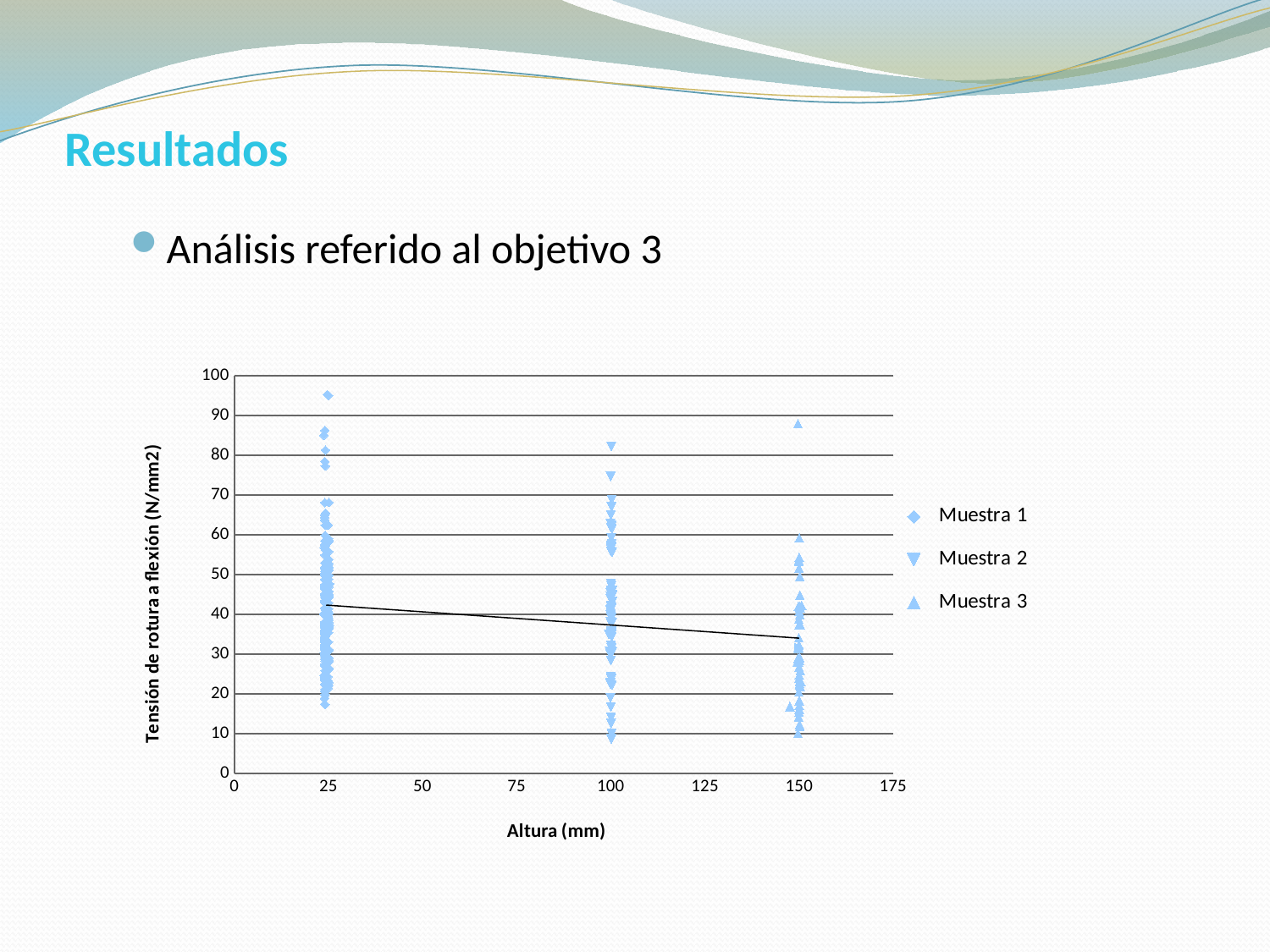
Is the highest Muestra 2 point greater or less than 80? greater At which Altura (mm) value are the Muestra 2 points plotted? 100 At which Altura (mm) value are the Muestra 1 points plotted? 25 At which Altura (mm) value are the Muestra 3 points plotted? 150 Is the highest Muestra 1 point greater or less than 90? greater How many series does the legend list? 3 What is the title of the vertical axis? Tensión de rotura a flexión (N/mm2) Which series contains the single highest point on the chart? Muestra 1 What is the maximum value shown on the vertical axis? 100 What are the names of the series in the legend? Muestra 1, Muestra 2, Muestra 3 Does the black trend line rise or fall as Altura (mm) increases? fall What kind of chart is shown on the slide? scatter chart